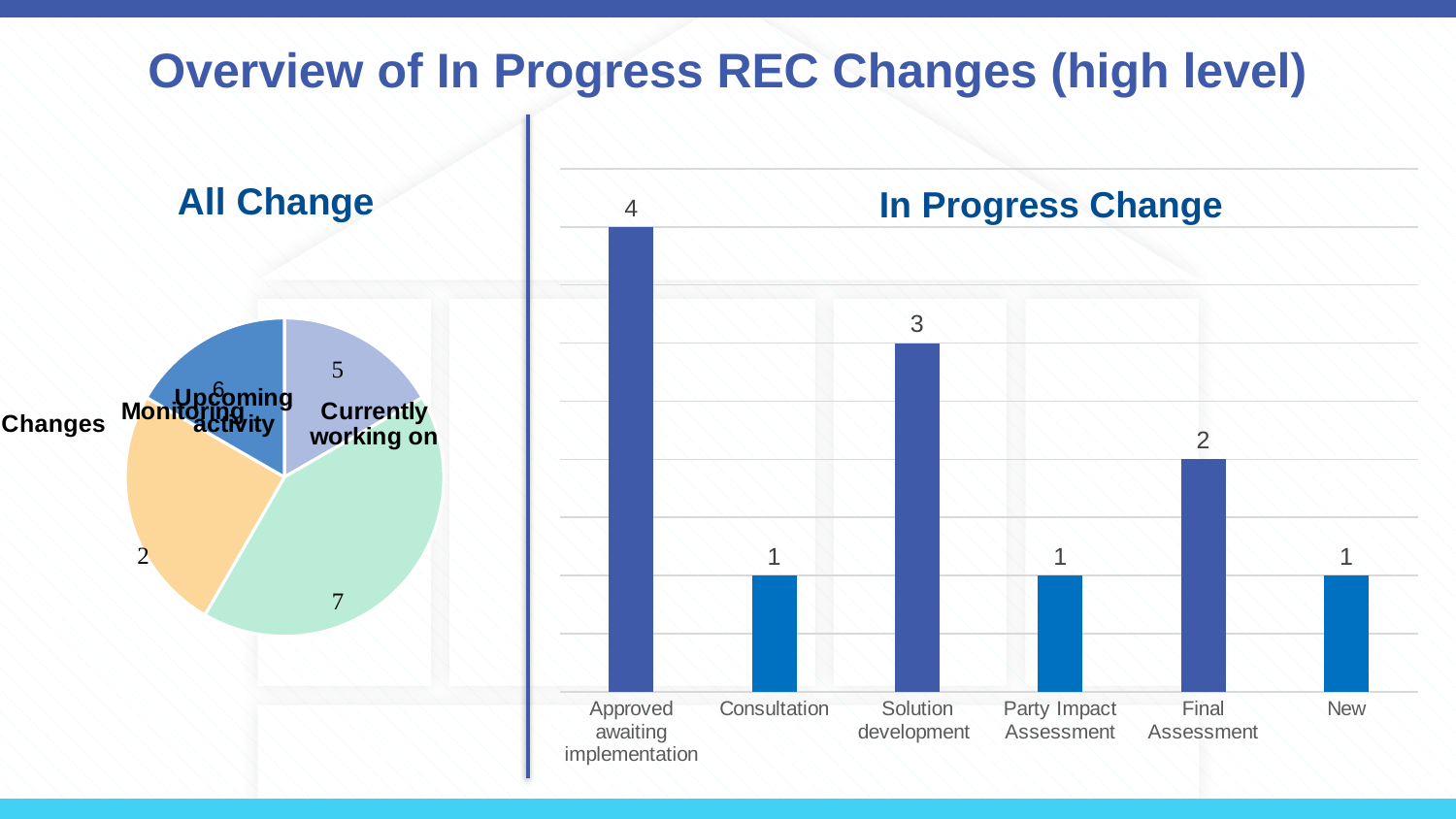
In the 'In Progress Change' chart, what is the value for Final Assessment? 2 In the 'In Progress Change' chart, what is the difference between Approved awaiting implementation and Solution development? 1 In the 'All Change' pie chart, what is the value of the 'Currently working on' slice? 5 In the 'In Progress Change' chart, what is the value for Approved awaiting implementation? 4 How many categories are shown in the 'In Progress Change' chart? 6 In the 'In Progress Change' chart, which is larger: Solution development or Final Assessment? Solution development What kind of chart is the 'All Change' chart? Pie chart In the 'In Progress Change' chart, what is the value for Solution development? 3 In the 'In Progress Change' chart, which category has the highest value? Approved awaiting implementation What kind of chart is the 'In Progress Change' chart? Bar chart In the 'All Change' pie chart, what is the value of the largest slice? 7